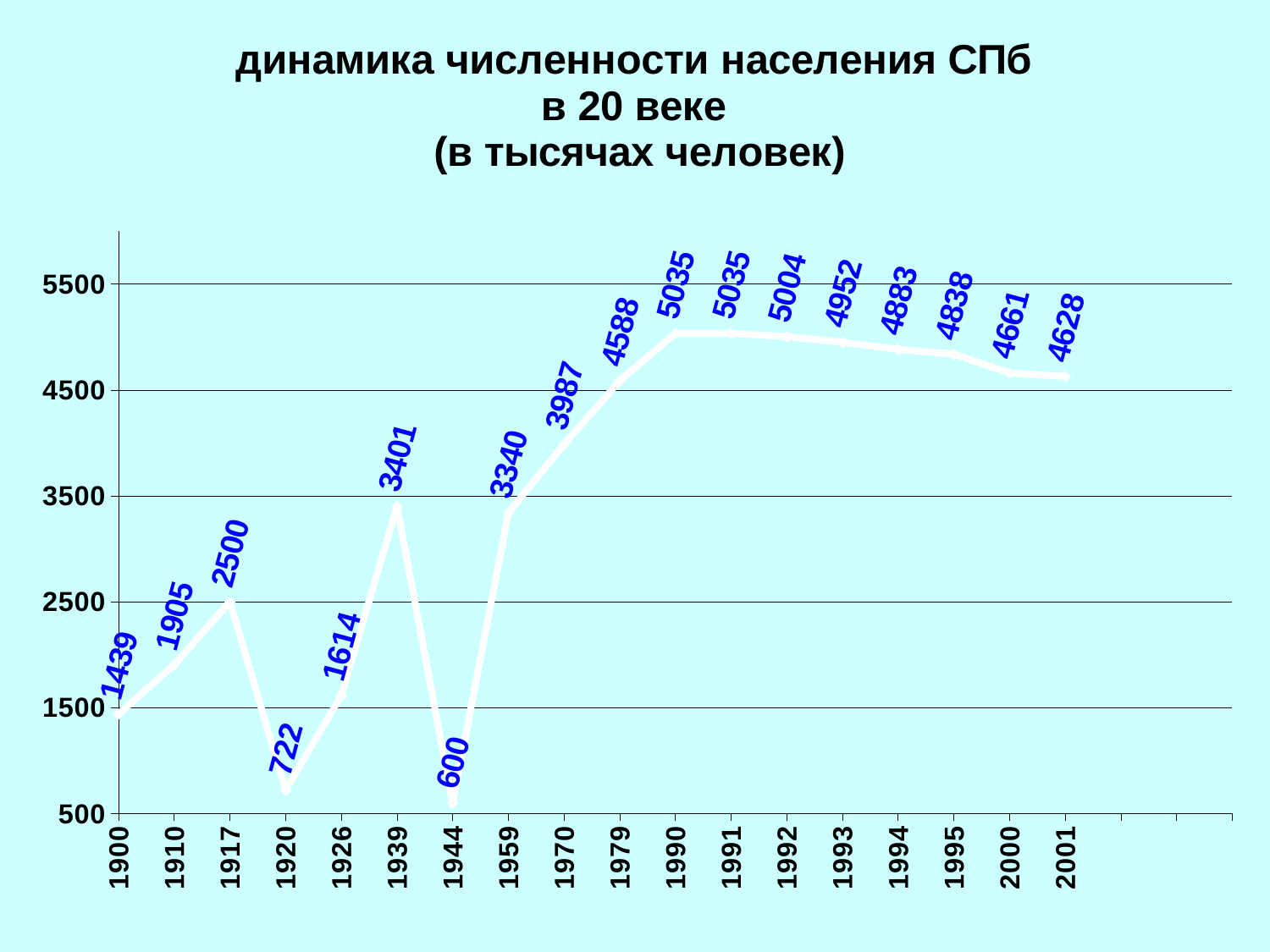
What is the population value shown for 2001? 4628 What is the population value shown for 1944? 600 What is the difference between the values for 1917 and 1920? 1778 What kind of chart is shown on the slide? line chart How many years (data points) are plotted on the chart? 18 In which year does the chart show the lowest population value? 1944 What is the highest population value shown on the chart? 5035 What is the population value shown for 1979? 4588 Which year has the larger value, 1939 or 1959? 1939 What is the difference between the values for 2000 and 2001? 33 What is the population value shown for 1920? 722 Do the values rise or fall from 1990 to 2001? fall